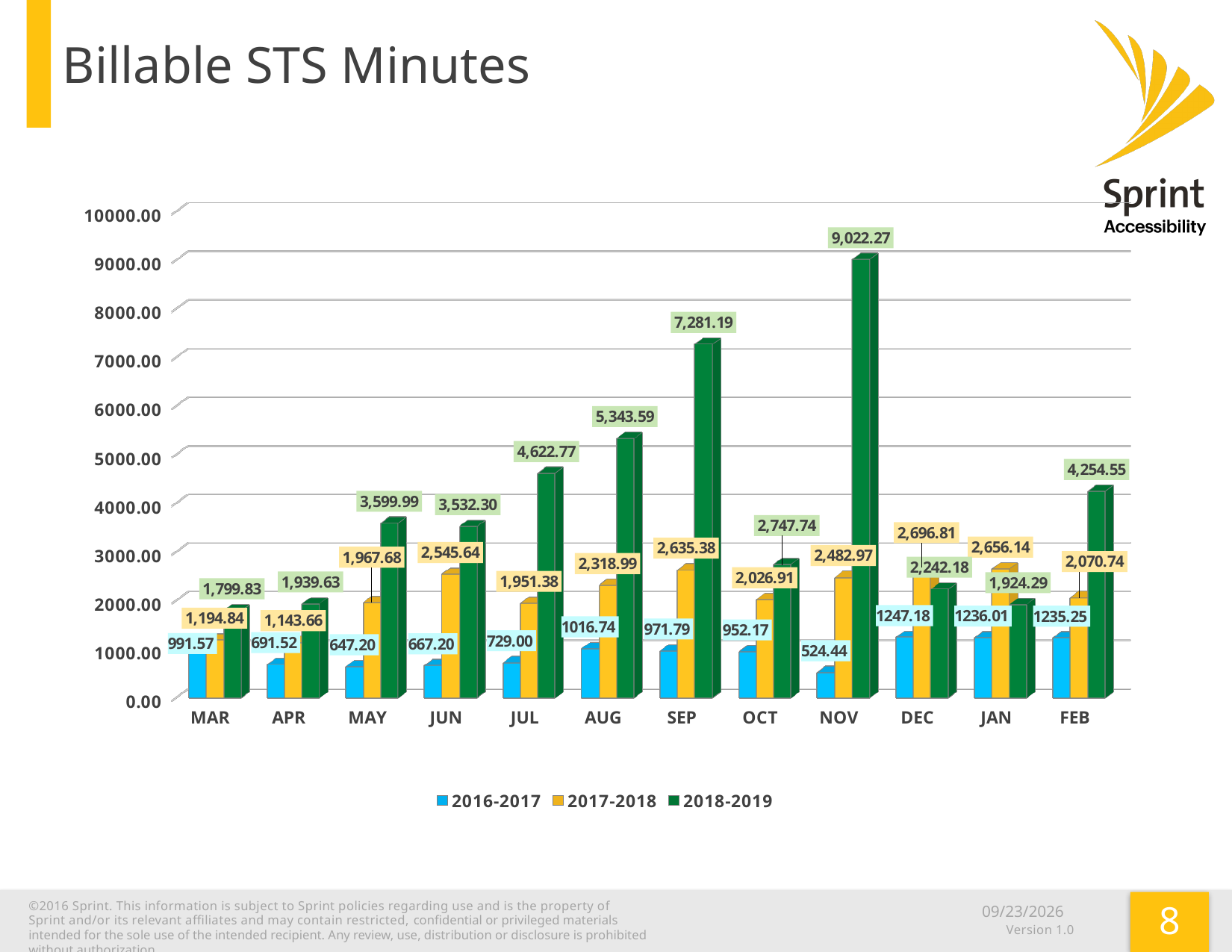
What is the value for MAY in the 2017-2018 series? 1,967.68 What is the value for NOV in the 2018-2019 series? 9,022.27 Which month has the lowest value in the 2016-2017 series? NOV What is the difference between the 2018-2019 and 2017-2018 values for NOV? 6,539.30 Which month has the highest value in the 2017-2018 series? DEC How many months are shown on the x axis? 12 Which month has the highest value in the 2018-2019 series? NOV How many series does the legend list? 3 What is the value for AUG in the 2016-2017 series? 1016.74 Is the value for SEP in the 2018-2019 series greater or less than 7000? greater In DEC, which series has the larger value, 2017-2018 or 2018-2019? 2017-2018 What kind of chart is shown on the slide? bar chart